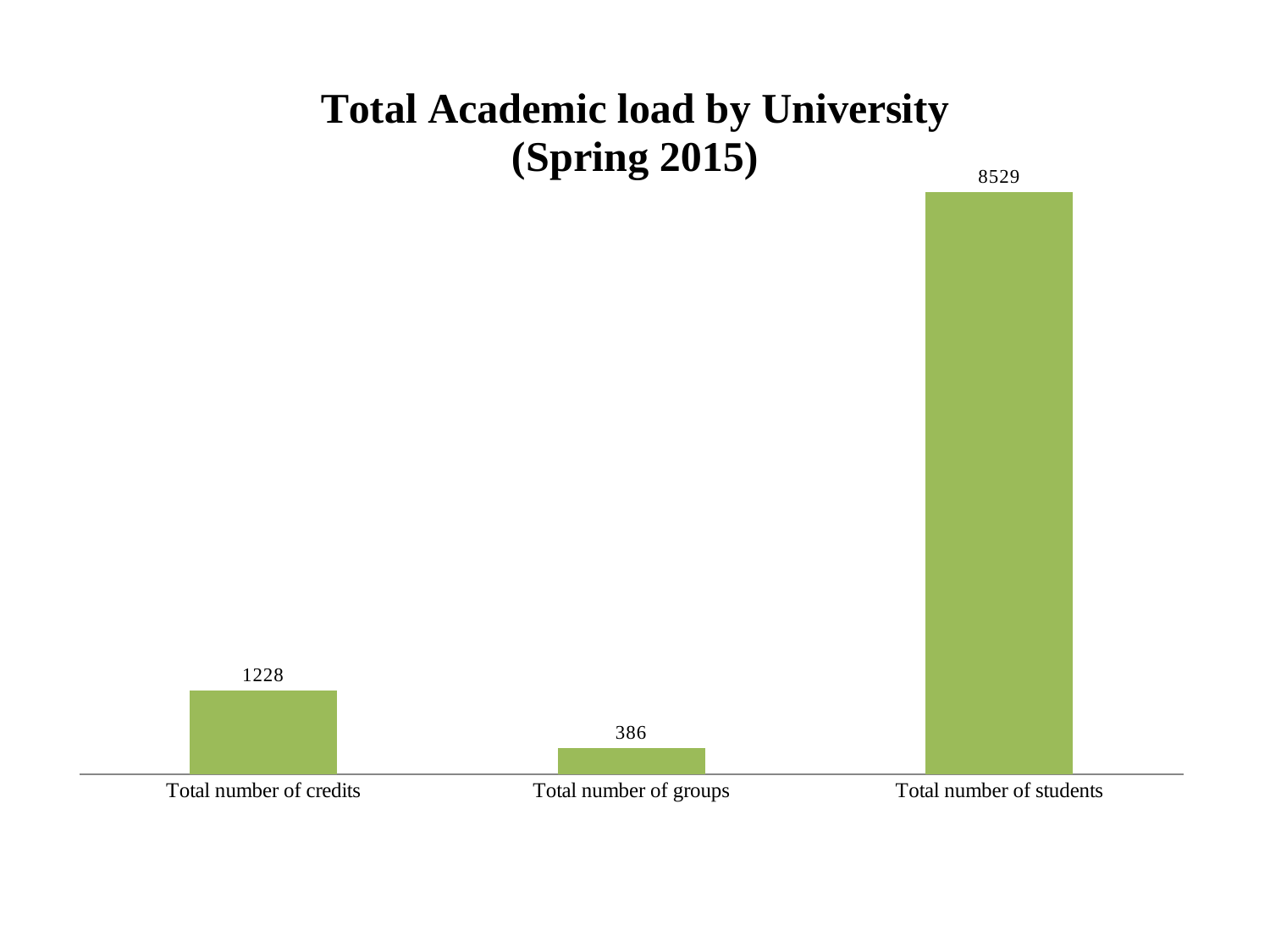
How many categories are shown in the chart? 3 Which category has the highest value? Total number of students What colour are the bars in the chart? Green What is the value for Total number of credits? 1228 What is the difference between Total number of credits and Total number of groups? 842 What kind of chart is shown on the slide? Bar chart What is the value for Total number of students? 8529 What is the value for Total number of groups? 386 Which is larger, Total number of credits or Total number of groups? Total number of credits Which category has the lowest value? Total number of groups What is the title of the chart? Total Academic load by University (Spring 2015) What is the difference between Total number of students and Total number of credits? 7301